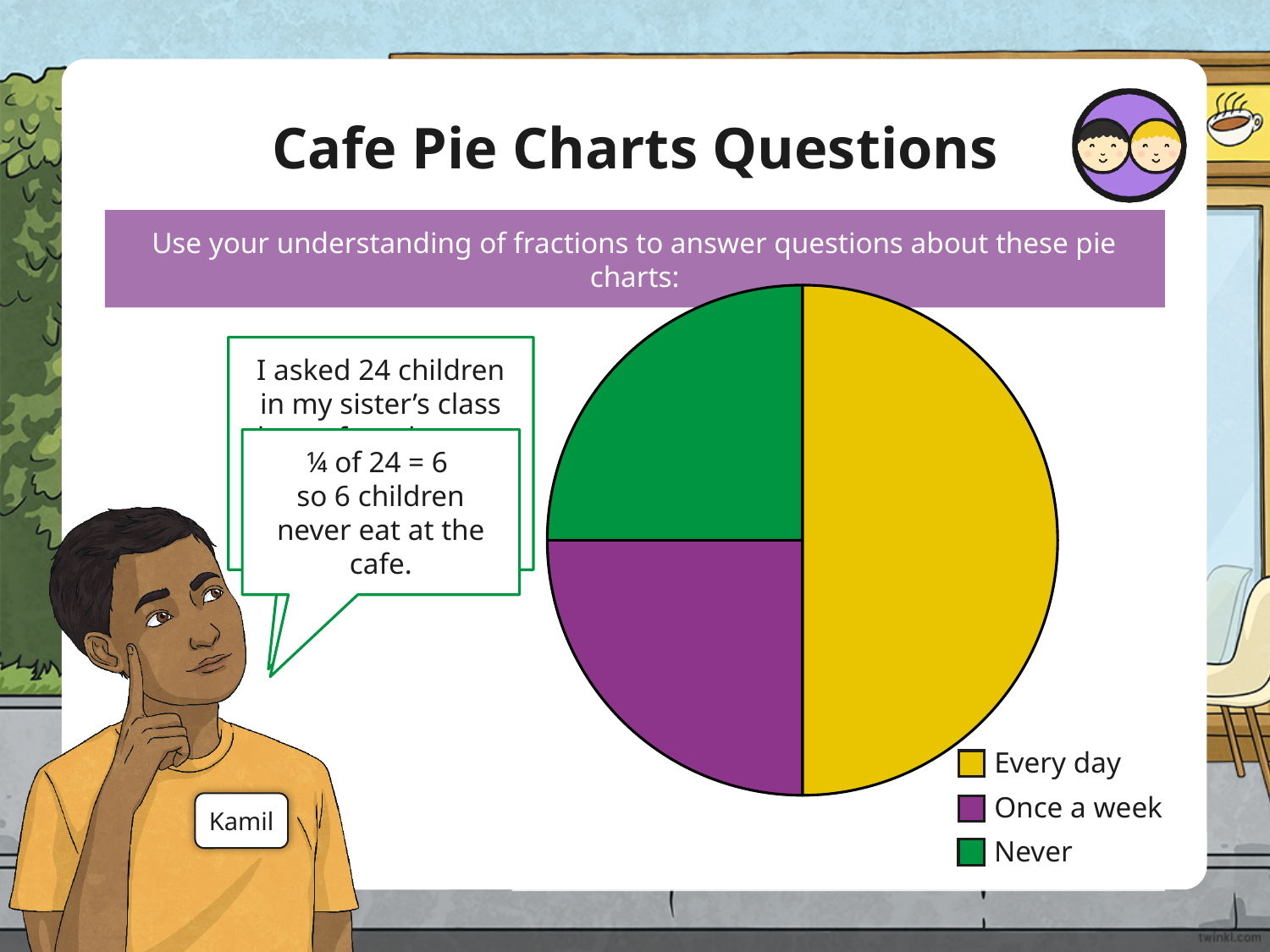
How many slices does the pie chart have? 3 How many children were asked in total for the pie chart? 24 What colour is the Every day slice of the pie chart? yellow Which slice is larger, Every day or Once a week? Every day Which category takes up the largest slice of the pie chart? Every day Which slice is larger, Every day or Never? Every day What fraction of the pie chart does the Never slice represent? ¼ How many entries does the legend of the pie chart list? 3 Which category is shown in purple on the pie chart? Once a week According to the slide, how many children never eat at the cafe? 6 What kind of chart is shown on the slide? pie chart